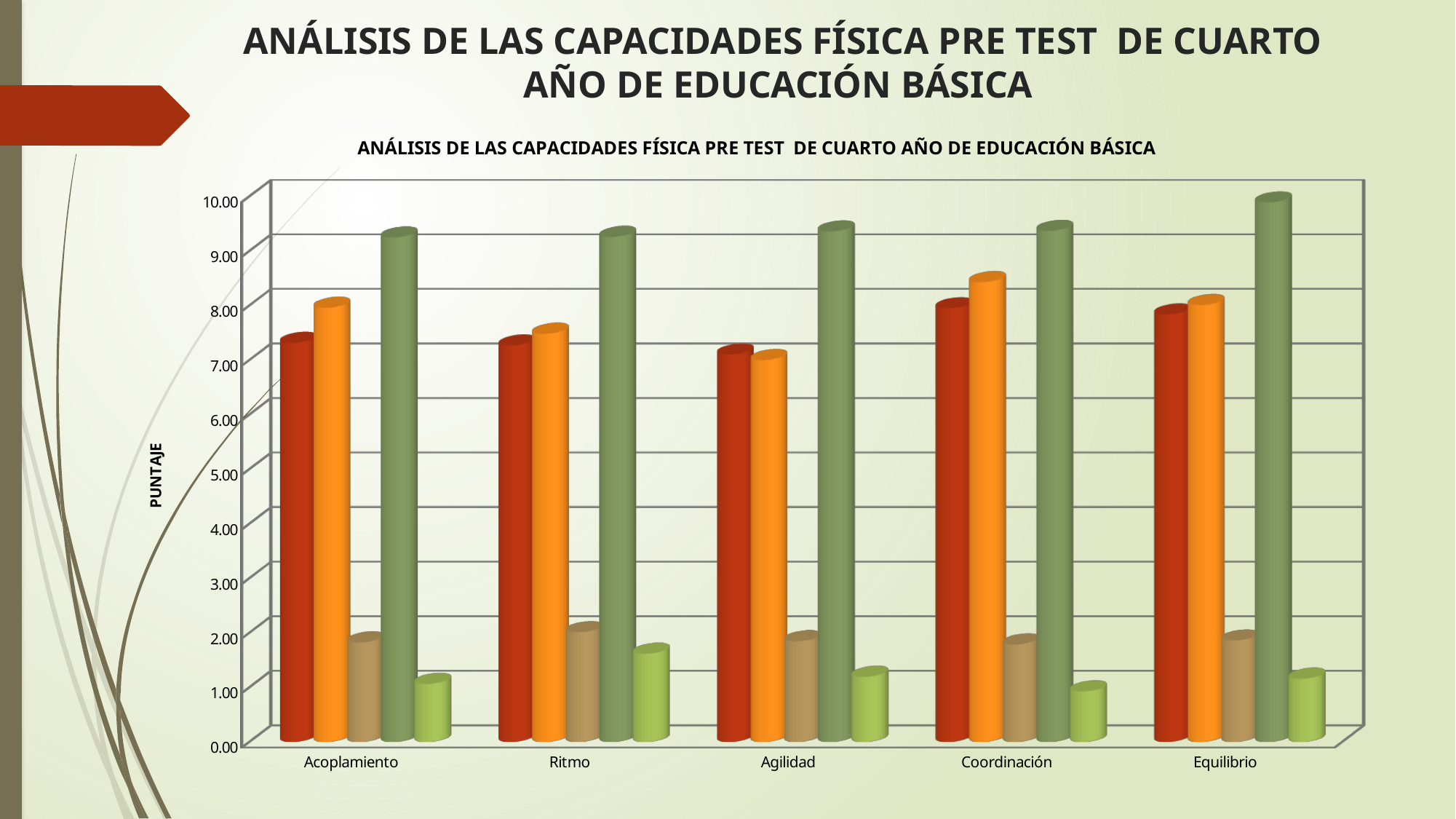
Which category has the tallest dark green bar? Equilibrio What is the label of the vertical axis of the chart? PUNTAJE What is the title of the chart? ANÁLISIS DE LAS CAPACIDADES FÍSICA PRE TEST DE CUARTO AÑO DE EDUCACIÓN BÁSICA Is the value of the orange bar for Coordinación greater or less than 8.00? greater What kind of chart is shown on the slide? Bar chart Is the value of the light green bar for Ritmo greater or less than 2.00? less Is the value of the red bar for Agilidad greater or less than 8.00? less How many categories are shown along the x axis of the chart? 5 Which is larger, the orange bar for Coordinación or the orange bar for Agilidad? Coordinación Which category has the tallest light green bar? Ritmo